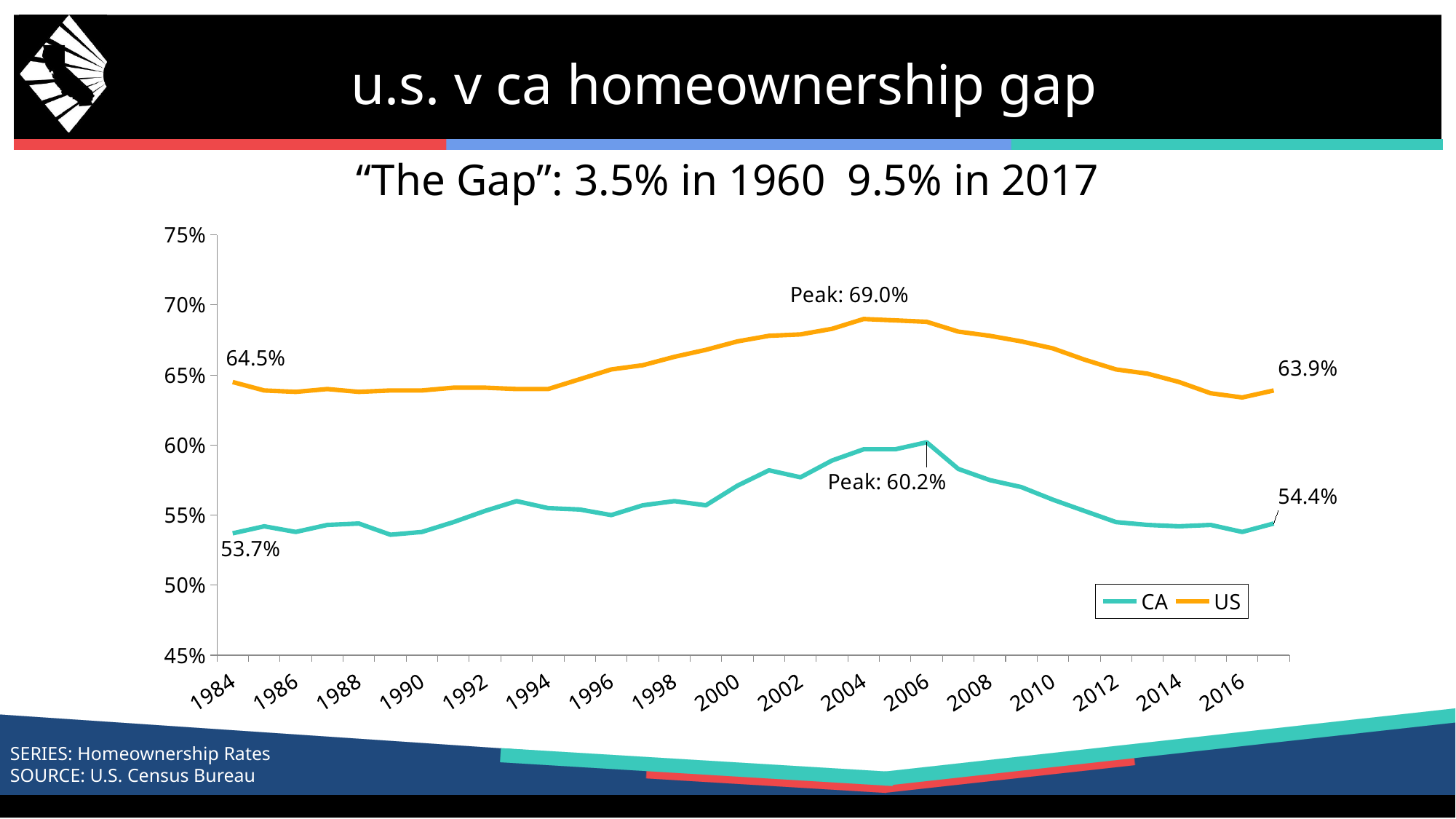
What is the US homeownership rate at the end of the series in 2017? 63.9% What is the CA homeownership rate at the start of the series in 1984? 53.7% How many series does the legend list? 2 What is the difference between the US and CA rates at the end of the series in 2017? 9.5% Is the US value in 2010 greater or less than 65%? greater What is the CA homeownership rate at the end of the series in 2017? 54.4% What is the US homeownership rate at the start of the series in 1984? 64.5% Which series is higher throughout the chart, CA or US? US What is the peak value labelled for the US series? 69.0% What is the peak value labelled for the CA series? 60.2% What is the difference between the US peak and the CA peak? 8.8% What kind of chart is shown on the slide? Line chart